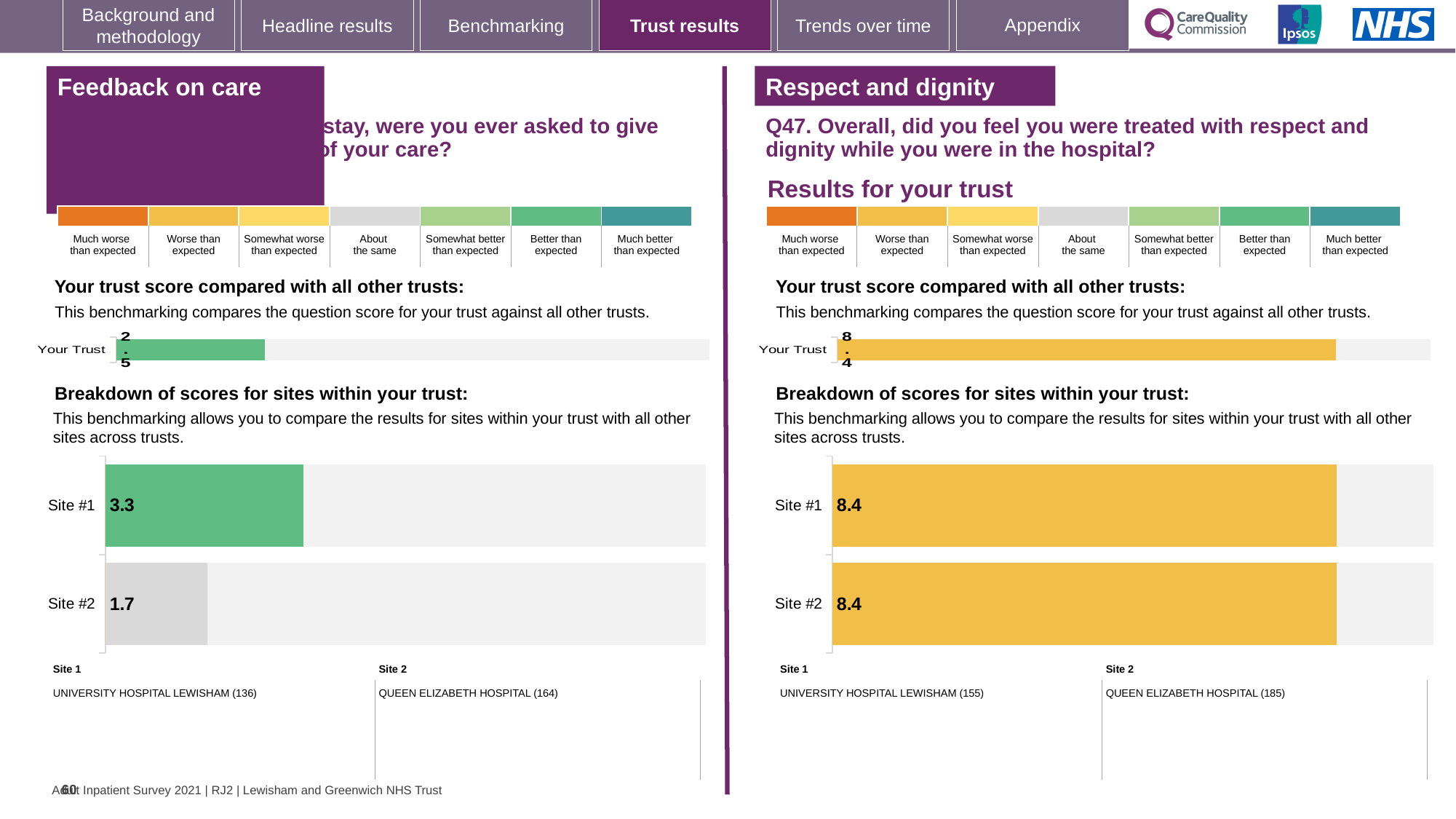
What type of chart is used for the site breakdown under 'Feedback on care' on the left? Bar chart In the 'Feedback on care' site breakdown chart on the left, which site has the higher score? Site #1 In the 'Feedback on care' trust score chart on the left, what is the score for Your Trust? 2.5 In the 'Feedback on care' site breakdown chart on the left, what is the score for Site #1? 3.3 In the 'Respect and dignity' site breakdown chart on the right, what colour are the bars for Site #1 and Site #2? Yellow In the 'Respect and dignity' site breakdown chart on the right, what is the score for Site #1? 8.4 In the 'Respect and dignity' site breakdown chart on the right, what is the score for Site #2? 8.4 In the 'Feedback on care' site breakdown chart on the left, is the Site #2 bar larger or smaller than the Site #1 bar? Smaller In the 'Feedback on care' site breakdown chart on the left, what is the score for Site #2? 1.7 In the 'Feedback on care' site breakdown chart on the left, what is the difference between the Site #1 and Site #2 scores? 1.6 In the 'Respect and dignity' trust score chart on the right, what is the score for Your Trust? 8.4 In the 'Respect and dignity' site breakdown chart on the right, how many sites are shown? 2